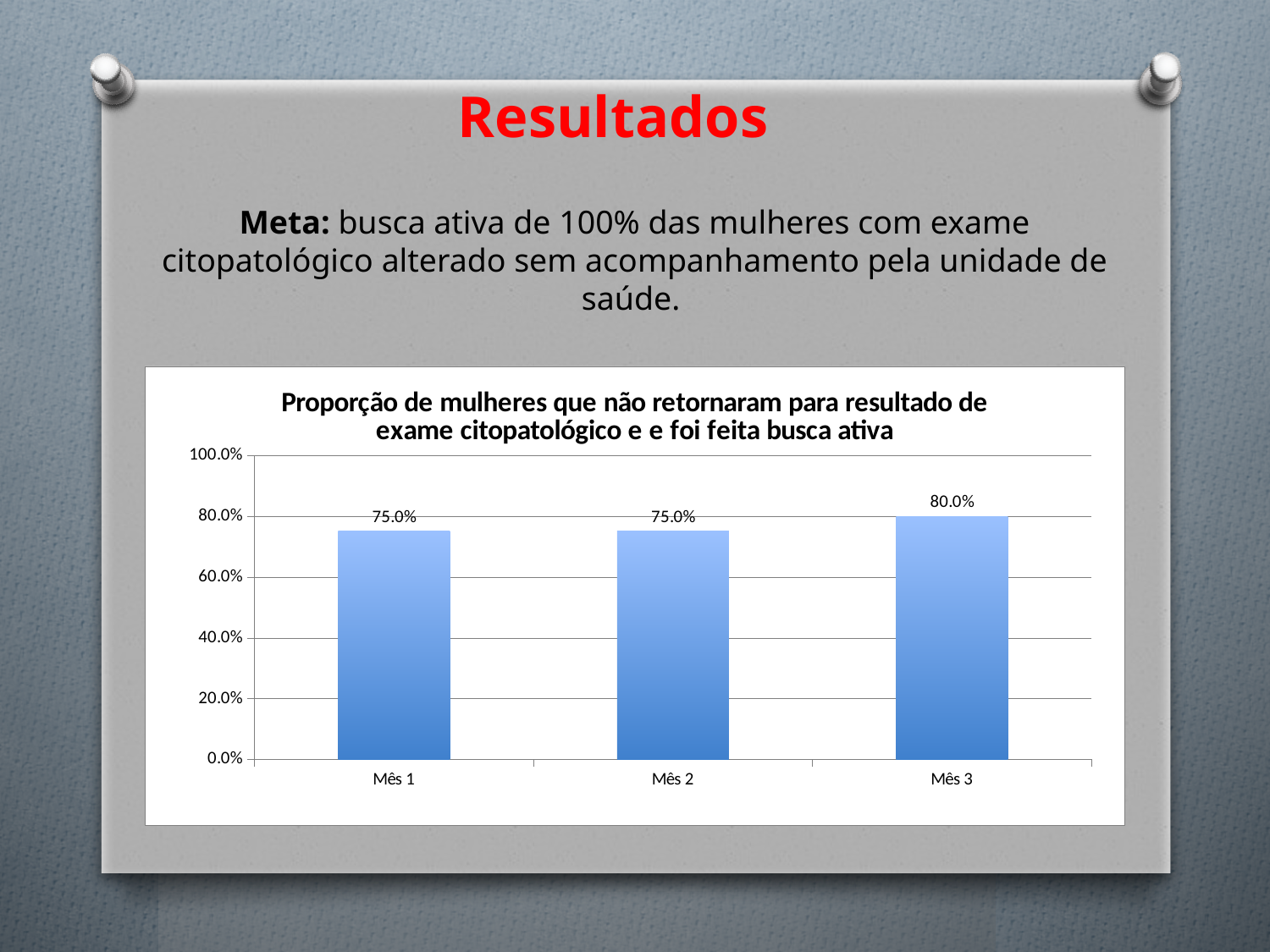
What is the value for Mês 1? 75.0% What kind of chart is shown on the slide? bar chart Which month has the highest value? Mês 3 What is the value for Mês 3? 80.0% How many months are shown on the x axis? 3 What is the difference between the values for Mês 3 and Mês 2? 5.0% Is the value for Mês 2 greater or less than 60.0%? greater Do Mês 1 and Mês 2 have the same value? Yes What is the title of the chart? Proporção de mulheres que não retornaram para resultado de exame citopatológico e e foi feita busca ativa Which is larger, the value for Mês 1 or the value for Mês 3? Mês 3 Do the values rise or fall from Mês 2 to Mês 3? rise What is the highest value shown on the y axis? 100.0%